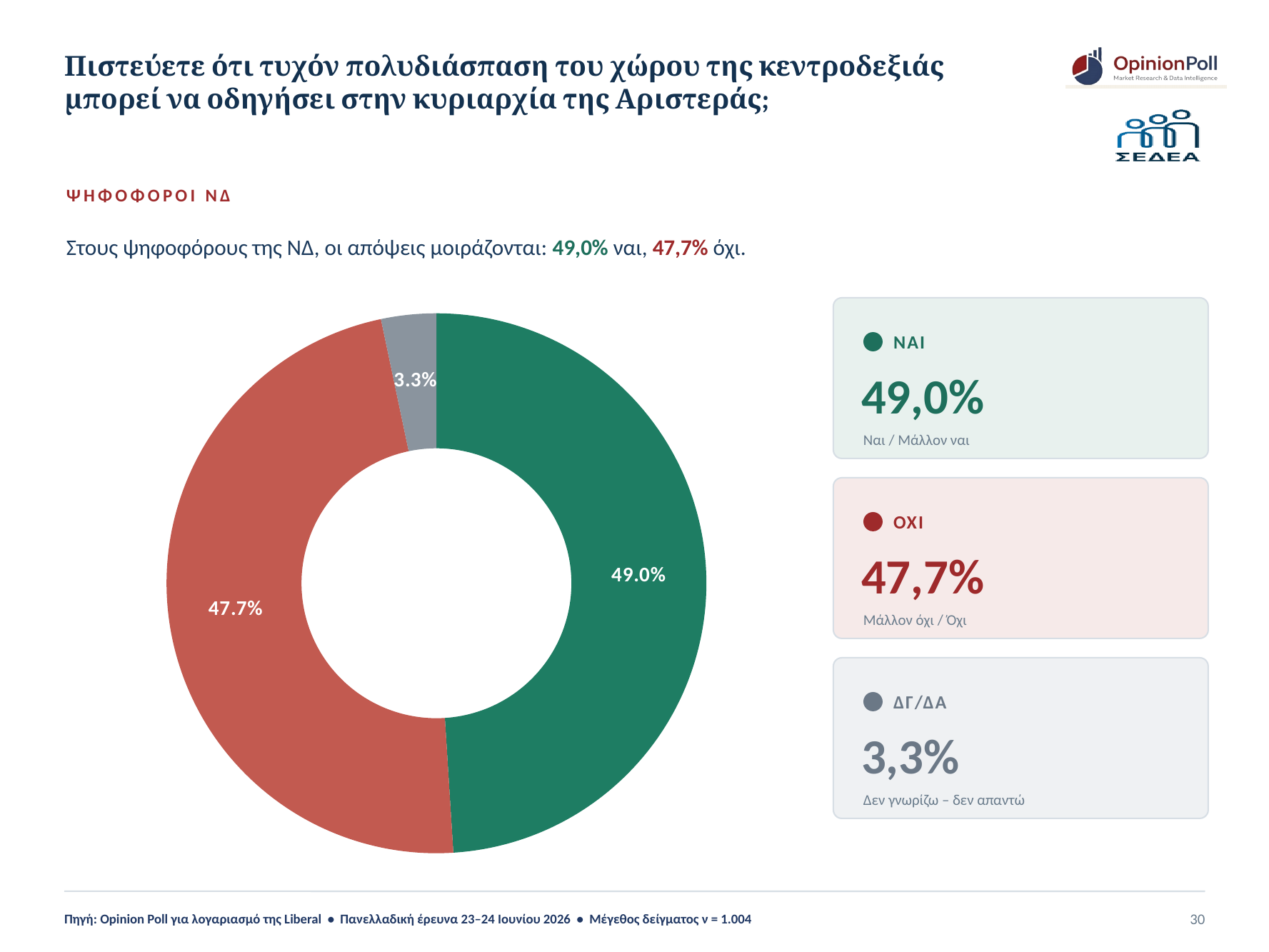
What kind of chart is shown on the slide? pie chart (donut) What share of the chart does the ΟΧΙ slice represent? 47.7% Which category has the largest slice in the chart? ΝΑΙ What is the difference in percentage points between the ΝΑΙ and ΟΧΙ slices? 1.3 percentage points Which category has the smallest slice in the chart? ΔΓ/ΔΑ What percentage does the ΟΧΙ slice of the donut chart show? 47.7% What percentage does the ΔΓ/ΔΑ slice of the donut chart show? 3.3% What percentage does the ΝΑΙ slice of the donut chart show? 49.0% Which voter group does the chart refer to, according to the label above it? ΨΗΦΟΦΟΡΟΙ ΝΔ What colour is the ΝΑΙ slice in the chart? green How many slices does the chart have? 3 Which is larger, the ΟΧΙ slice or the ΔΓ/ΔΑ slice? ΟΧΙ